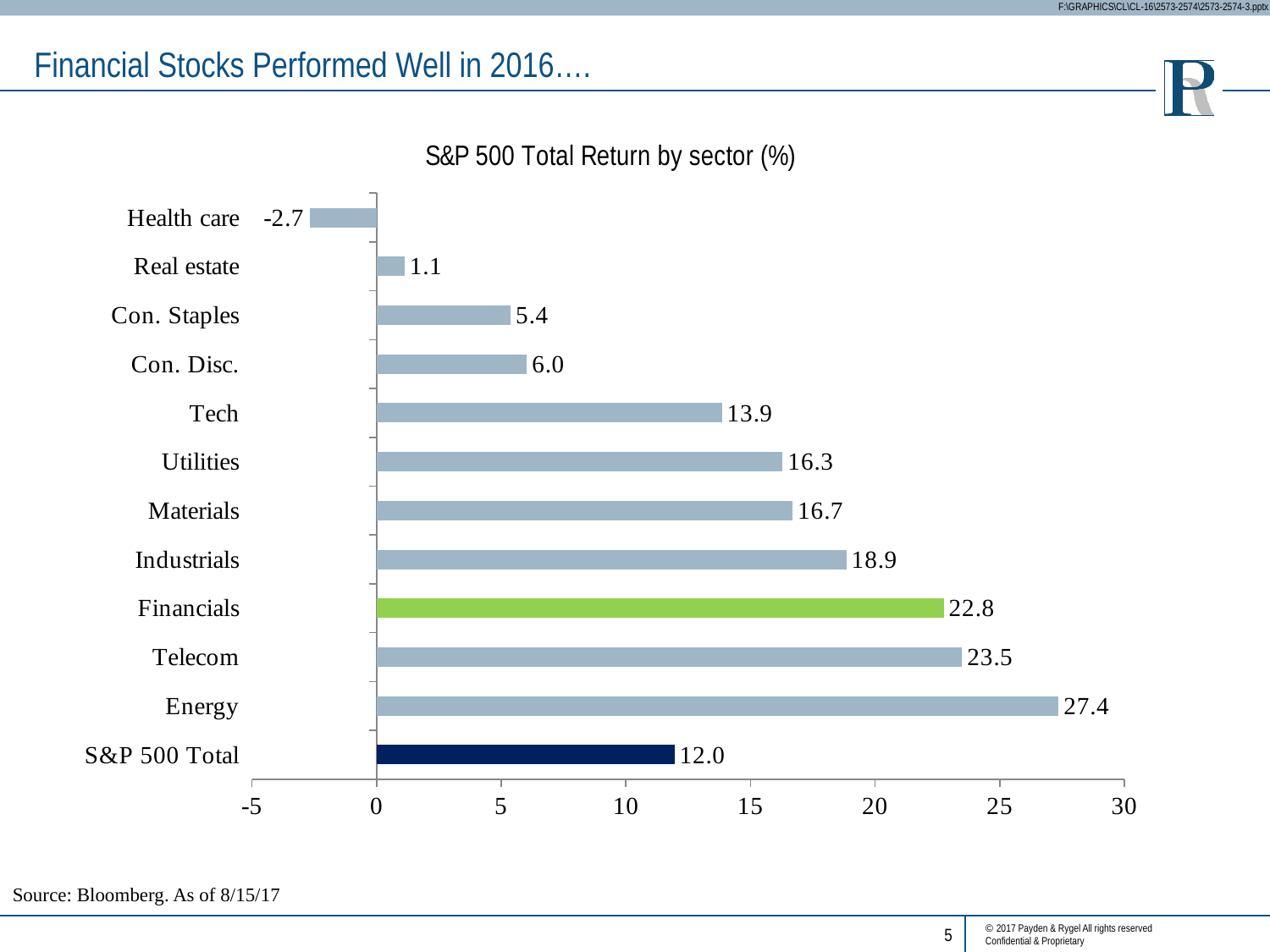
What is the total return for Health care? -2.7 How many bars are shown in the chart? 12 What kind of chart is shown on the slide? Bar chart What is the title of the chart? S&P 500 Total Return by sector (%) Which sector has the highest total return? Energy What is the value shown for S&P 500 Total? 12.0 Which has a higher total return, Telecom or Industrials? Telecom What is the total return for Financials? 22.8 Which sector has the lowest total return? Health care What is the difference between the Energy return and the Financials return? 4.6 Is the value for Tech greater or less than 15? less Which bar is highlighted in green? Financials